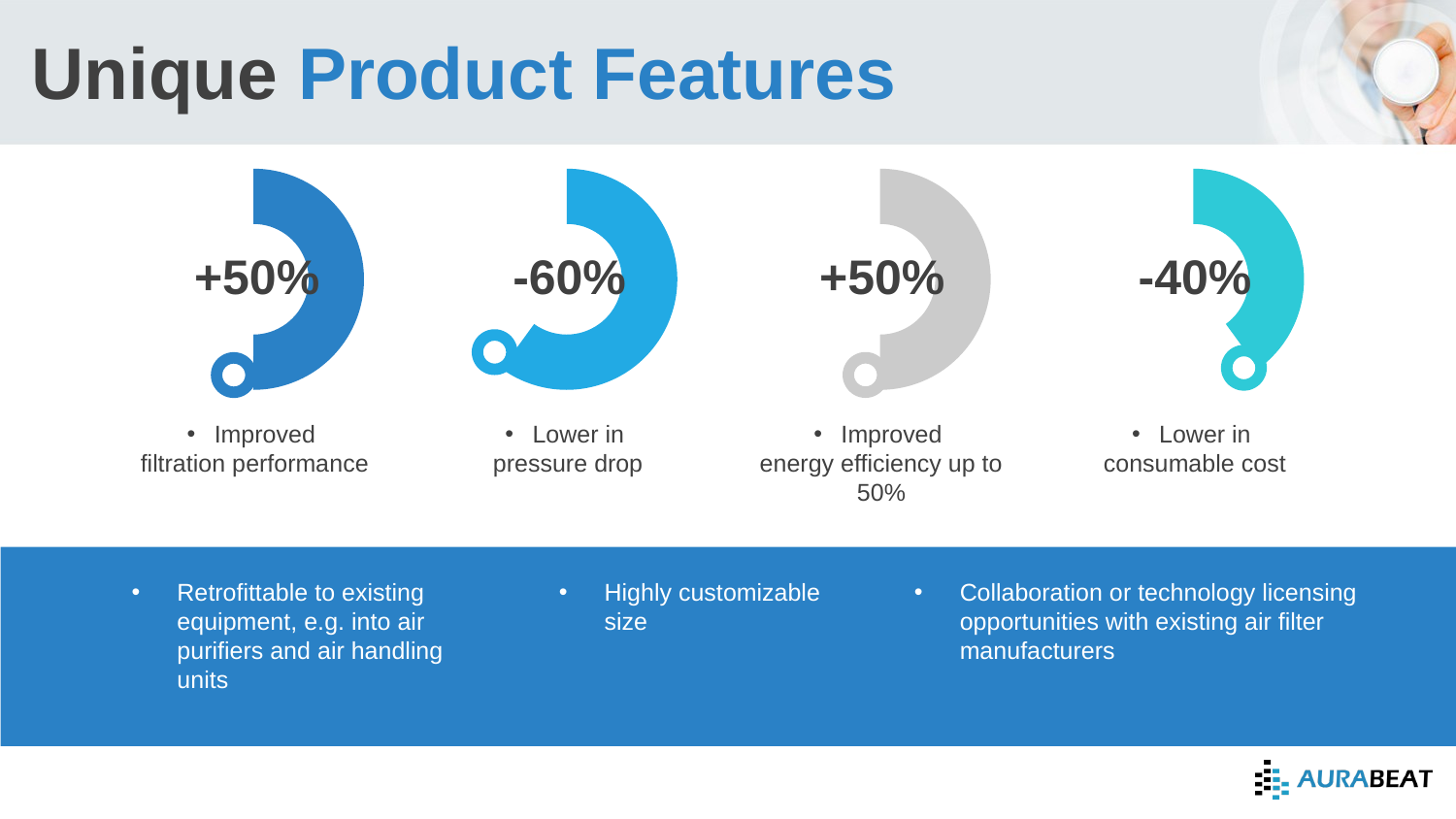
What value is shown for Improved filtration performance? +50% What is the difference between the -60% for Lower in pressure drop and the -40% for Lower in consumable cost? 20% What value is shown for Lower in consumable cost? -40% What colour is the ring graphic for Lower in consumable cost? Teal Is the reduction for Lower in pressure drop larger or smaller than the reduction for Lower in consumable cost? larger How many ring graphics with percentage values are shown on the slide? 4 Which feature shows the smallest reduction percentage? Lower in consumable cost What value is shown for Lower in pressure drop? -60% What value is shown for Improved energy efficiency? +50% What colour is the ring graphic for Improved energy efficiency? Grey Which feature shows the largest reduction percentage? Lower in pressure drop